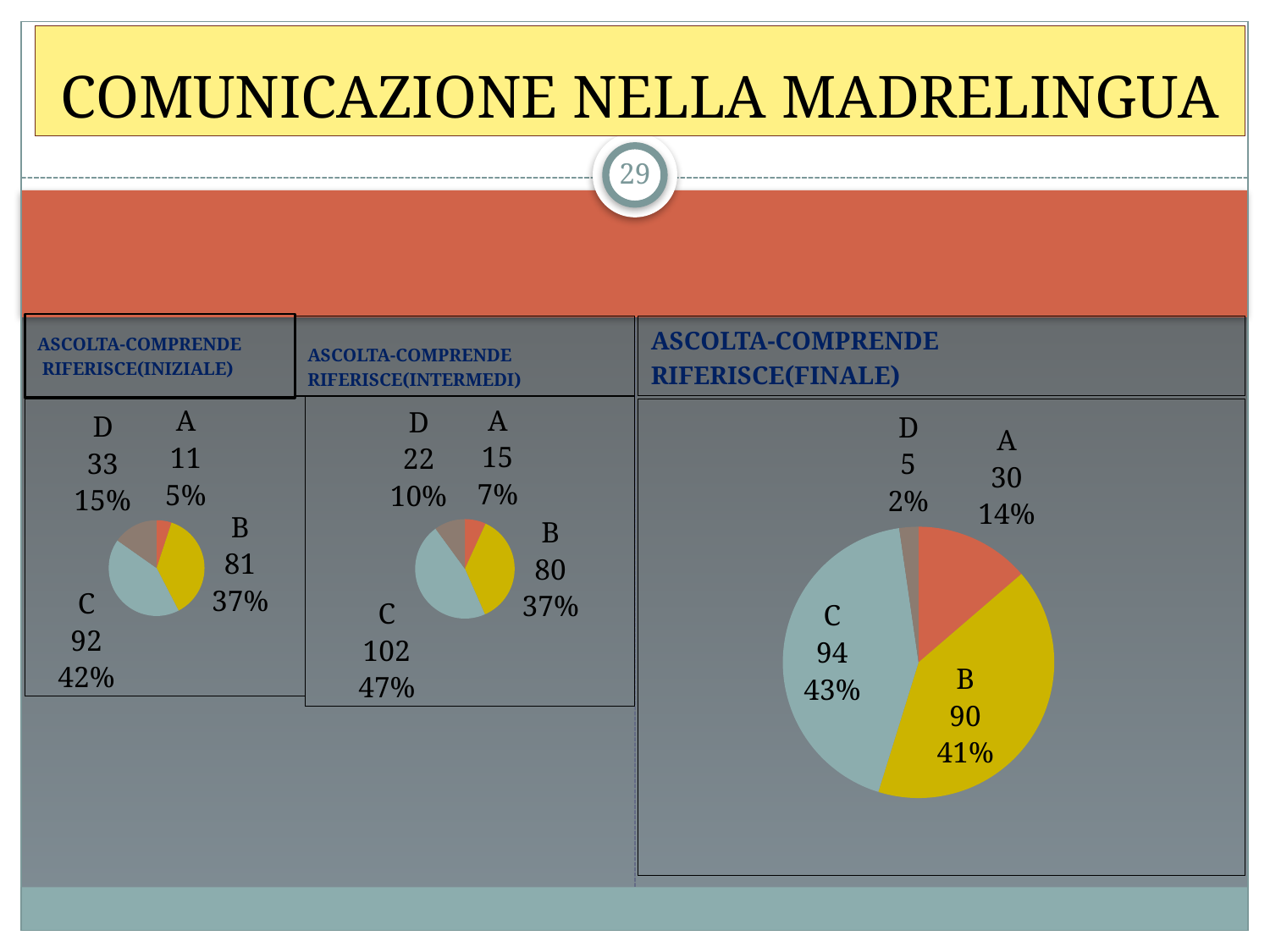
How many pie charts are shown on the slide? 3 In the ASCOLTA-COMPRENDE RIFERISCE(FINALE) chart, which category has the highest value? C In the ASCOLTA-COMPRENDE RIFERISCE(INIZIALE) chart, what percentage share does category D have? 15% In the ASCOLTA-COMPRENDE RIFERISCE(INIZIALE) chart, what value is shown for category B? 81 In the ASCOLTA-COMPRENDE RIFERISCE(INIZIALE) chart, what is the difference between the values for C and B? 11 In the ASCOLTA-COMPRENDE RIFERISCE(FINALE) chart, what percentage share does category B have? 41% How many categories does the ASCOLTA-COMPRENDE RIFERISCE(INTERMEDI) chart show? 4 What kind of chart is the ASCOLTA-COMPRENDE RIFERISCE(FINALE) chart? Pie chart In the ASCOLTA-COMPRENDE RIFERISCE(INTERMEDI) chart, what percentage share does category C have? 47% In the ASCOLTA-COMPRENDE RIFERISCE(FINALE) chart, what value is shown for category C? 94 In the ASCOLTA-COMPRENDE RIFERISCE(INTERMEDI) chart, which category has the lowest value? A In the ASCOLTA-COMPRENDE RIFERISCE(FINALE) chart, which is larger, the value for A or the value for D? A